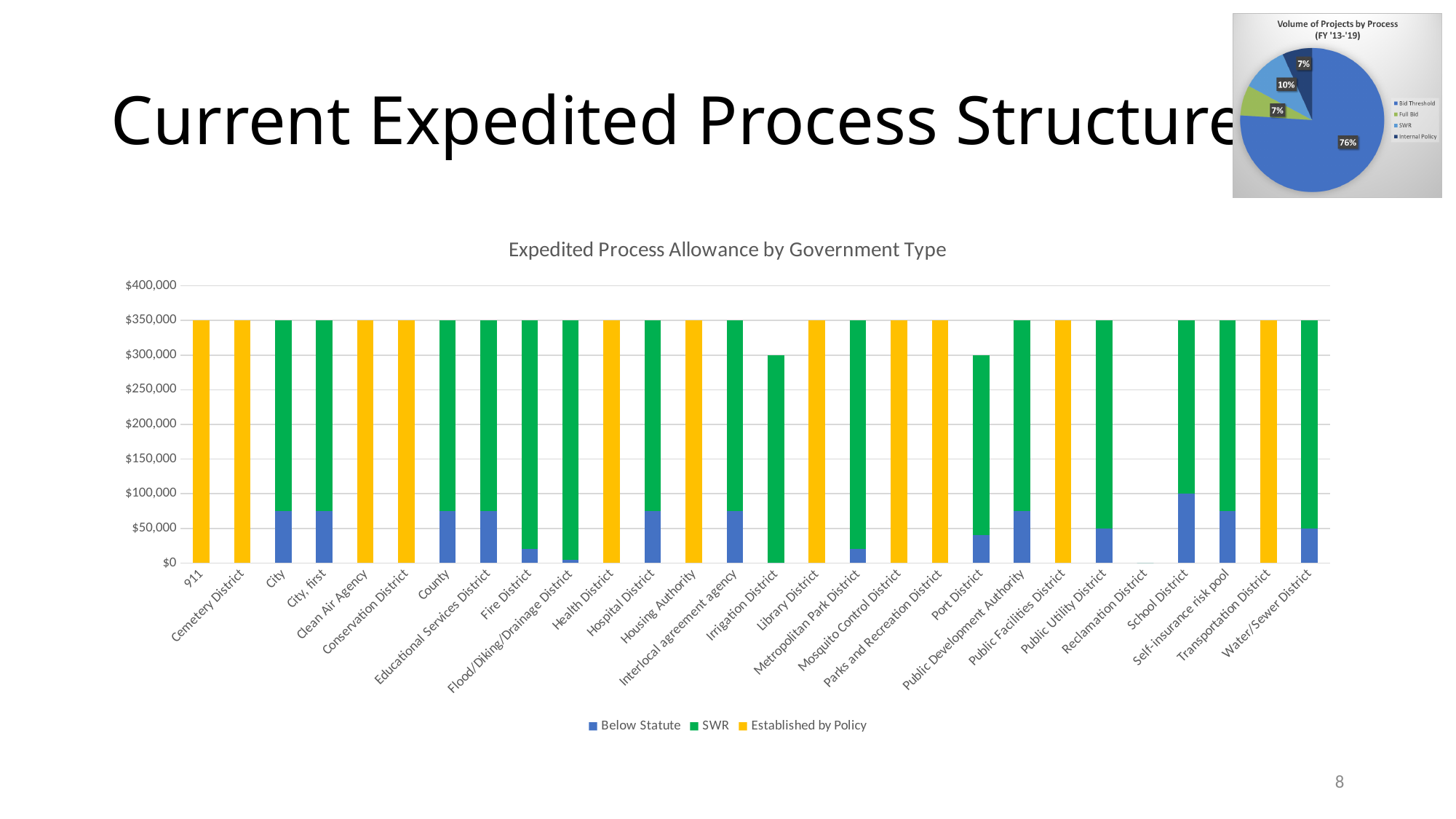
In the pie chart 'Volume of Projects by Process (FY '13-'19)', what share of projects is Bid Threshold? 76% In the pie chart 'Volume of Projects by Process (FY '13-'19)', what share of projects is SWR? 10% In the chart 'Expedited Process Allowance by Government Type', which government type has no bar at all? Reclamation District In the pie chart 'Volume of Projects by Process (FY '13-'19)', which process has the largest slice? Bid Threshold What kind of chart is 'Expedited Process Allowance by Government Type'? Stacked bar chart In the chart 'Expedited Process Allowance by Government Type', which bar is taller in total: 911 or Port District? 911 In the chart 'Expedited Process Allowance by Government Type', what is the total height of the bar for Irrigation District? $300,000 In the pie chart 'Volume of Projects by Process (FY '13-'19)', how many entries does the legend list? 4 In the chart 'Expedited Process Allowance by Government Type', how many series does the legend list? 3 In the chart 'Expedited Process Allowance by Government Type', how many government types are shown on the x axis? 28 In the chart 'Expedited Process Allowance by Government Type', what is the Below Statute value for School District? $100,000 In the chart 'Expedited Process Allowance by Government Type', is the Below Statute value for Fire District greater or less than $50,000? less